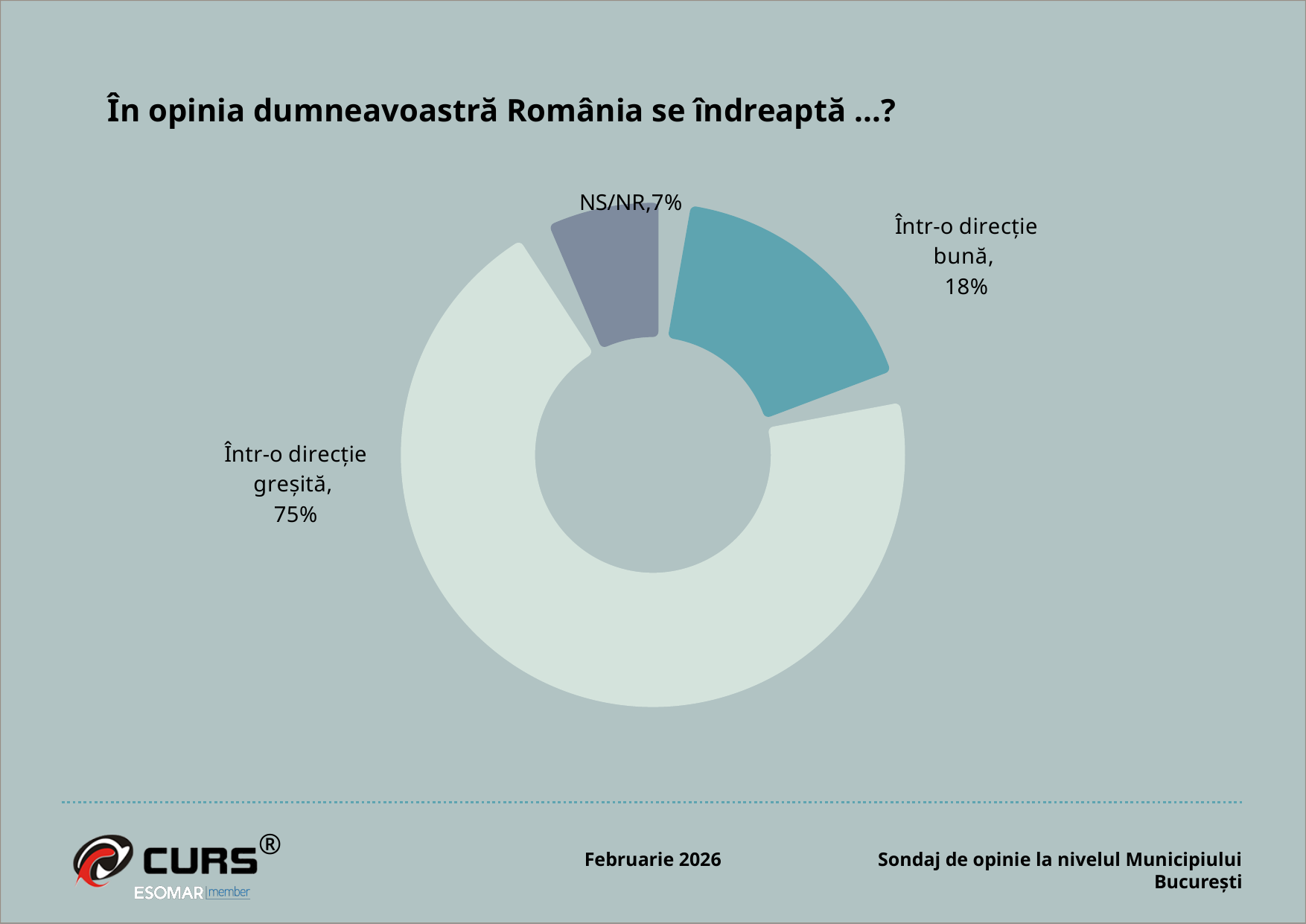
Which category has the smallest share of the pie? NS/NR Which is larger, the share for "Într-o direcție bună" or the share for NS/NR? Într-o direcție bună What is the title of the chart on the slide? În opinia dumneavoastră România se îndreaptă ...? What is the difference in percentage points between "Într-o direcție greșită" and "Într-o direcție bună"? 57 What month and year is shown at the bottom of the slide? Februarie 2026 What is the value shown for the NS/NR slice? 7% What percentage of respondents answered "Într-o direcție greșită"? 75% Which category has the largest share of the pie? Într-o direcție greșită What kind of chart is shown on the slide? Pie chart (doughnut) What is the difference in percentage points between "Într-o direcție bună" and NS/NR? 11 What percentage of respondents answered "Într-o direcție bună"? 18% How many slices does the chart have? 3